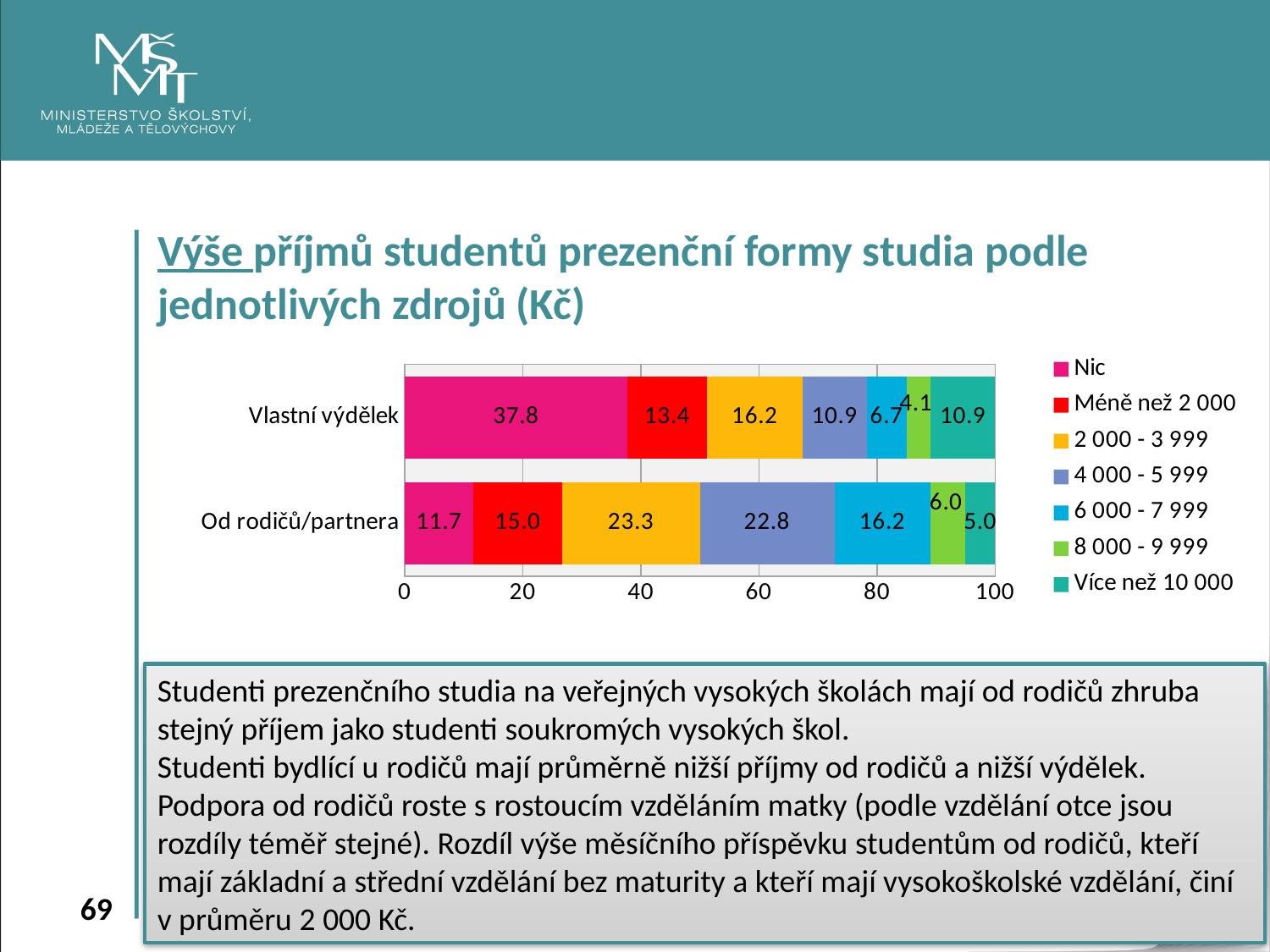
What type of chart is shown on the slide? stacked bar chart What is the total of the 'Od rodičů/partnera' stacked bar? 100.0 What is the value of the '2 000 - 3 999' segment for 'Od rodičů/partnera'? 23.3 What is the value of the '8 000 - 9 999' segment for 'Vlastní výdělek'? 4.1 What is the value of the 'Více než 10 000' segment for 'Od rodičů/partnera'? 5.0 Which category has the larger '4 000 - 5 999' segment, 'Vlastní výdělek' or 'Od rodičů/partnera'? Od rodičů/partnera Which segment is the smallest in the 'Vlastní výdělek' bar? 8 000 - 9 999 What is the value of the 'Nic' segment for 'Vlastní výdělek'? 37.8 How many series does the legend list? 7 How many categories are plotted on the y axis? 2 Which segment is the largest in the 'Od rodičů/partnera' bar? 2 000 - 3 999 What is the difference between the 'Nic' values for 'Vlastní výdělek' and 'Od rodičů/partnera'? 26.1